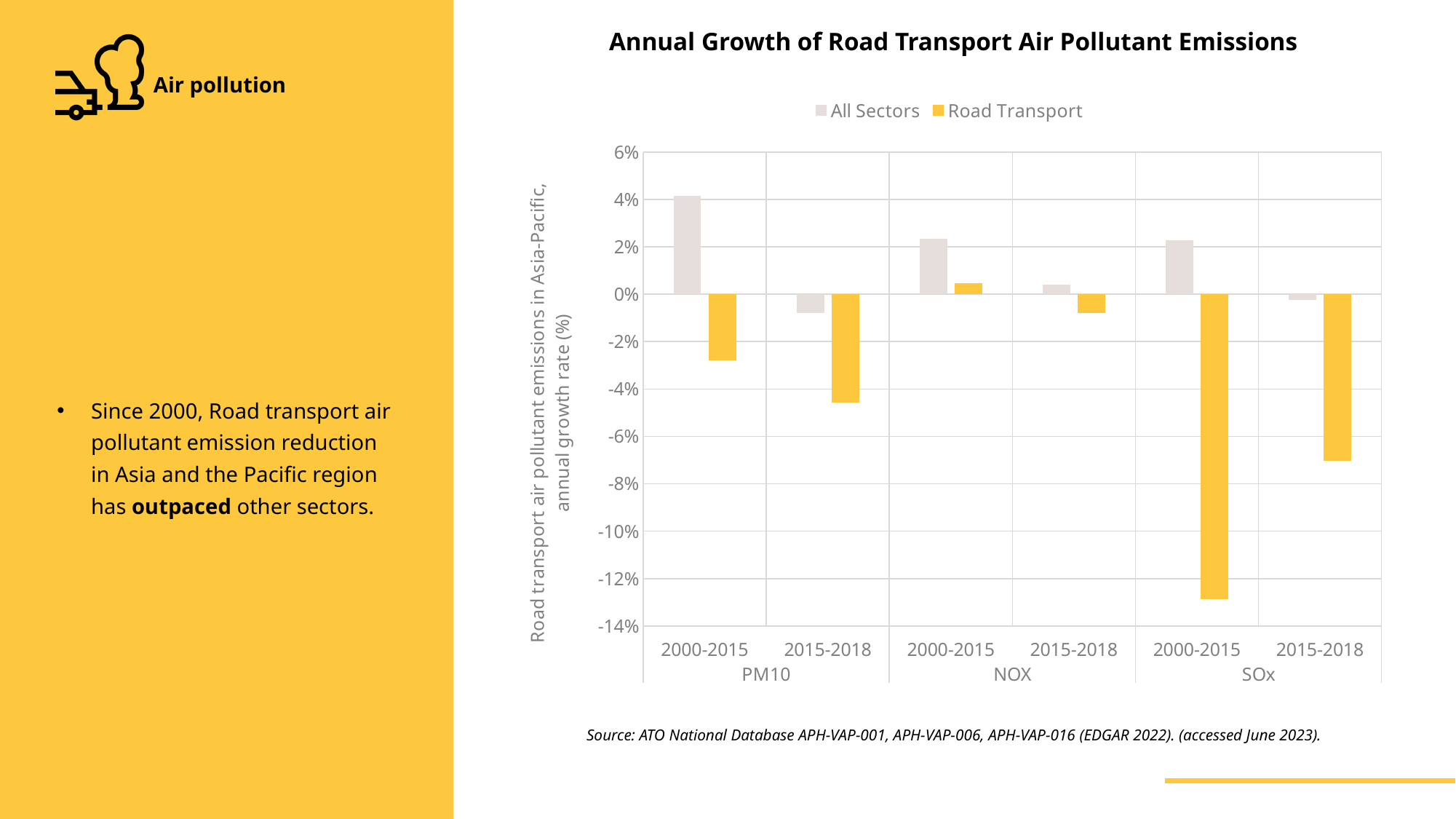
Is the Road Transport value for SOx 2015-2018 greater or less than -6%? less What are the two series named in the chart legend? All Sectors and Road Transport How many pollutants are shown along the x axis of the chart? 3 Is the Road Transport value for SOx 2000-2015 greater or less than -12%? less Which category has the lowest Road Transport value? SOx 2000-2015 For PM10 2000-2015, which is larger: the All Sectors value or the Road Transport value? All Sectors What kind of chart is shown on the slide? Bar chart What is the title of the chart? Annual Growth of Road Transport Air Pollutant Emissions For Road Transport, which is larger: the NOX 2000-2015 value or the NOX 2015-2018 value? NOX 2000-2015 Is the All Sectors value for PM10 2000-2015 greater or less than 2%? greater How many series does the chart legend list? 2 Which category has the highest All Sectors value? PM10 2000-2015